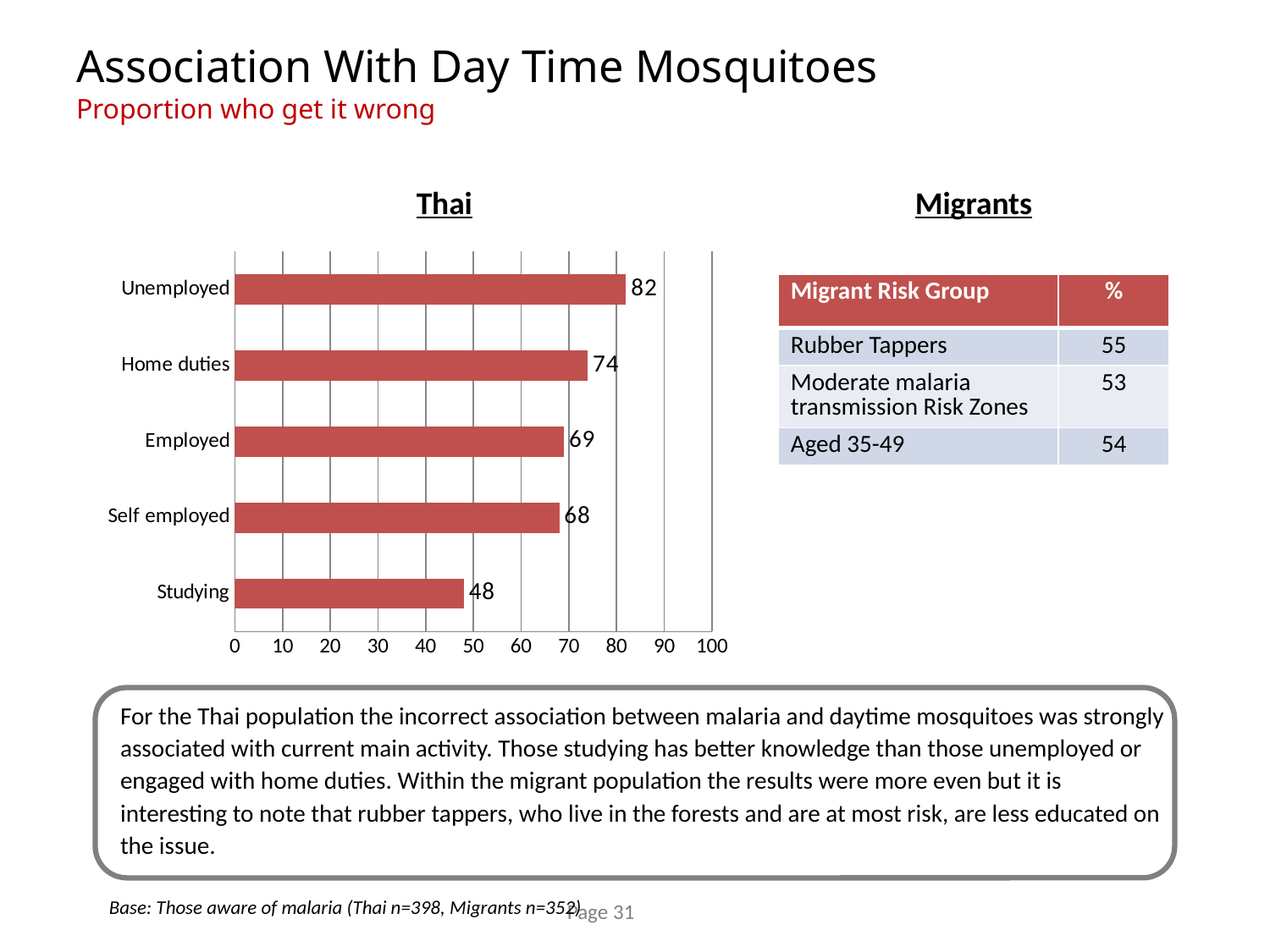
What kind of chart is the Thai chart? Bar chart What is the value for Studying in the Thai chart? 48 What is the maximum value shown on the x axis of the Thai chart? 100 What is the title of the chart on the left of the slide? Thai Which category has the lowest value in the Thai chart? Studying Which category has the highest value in the Thai chart? Unemployed What is the value for Unemployed in the Thai chart? 82 What is the difference between the values for Home duties and Employed in the Thai chart? 5 What is the value for Home duties in the Thai chart? 74 How many categories are shown in the Thai chart? 5 What is the difference between the values for Unemployed and Studying in the Thai chart? 34 Which is larger in the Thai chart, the value for Employed or the value for Studying? Employed